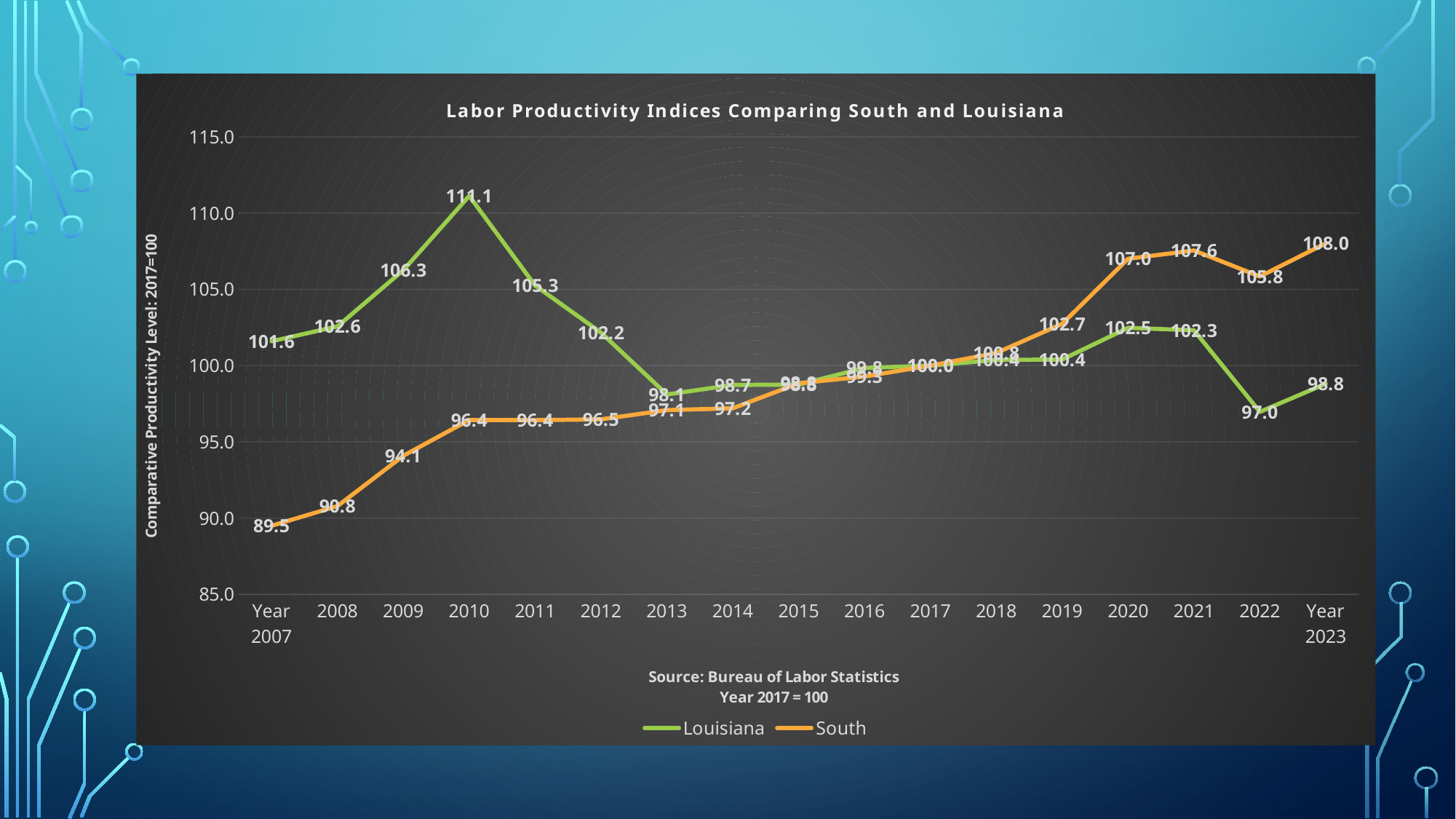
What is the South value in Year 2023? 108.0 What kind of chart is shown on the slide? line chart How many years are plotted on the x axis? 17 How many series does the legend list? 2 What is the Louisiana value in 2022? 97.0 Which series has the higher value in 2021, Louisiana or South? South What is the difference between the Louisiana and South values in 2010? 14.7 In which year is the South series at its lowest value? Year 2007 In which year does the Louisiana series reach its highest value? 2010 Is the South value in 2009 greater or less than 95.0? less What is the Louisiana value in 2010? 111.1 What is the South value in Year 2007? 89.5